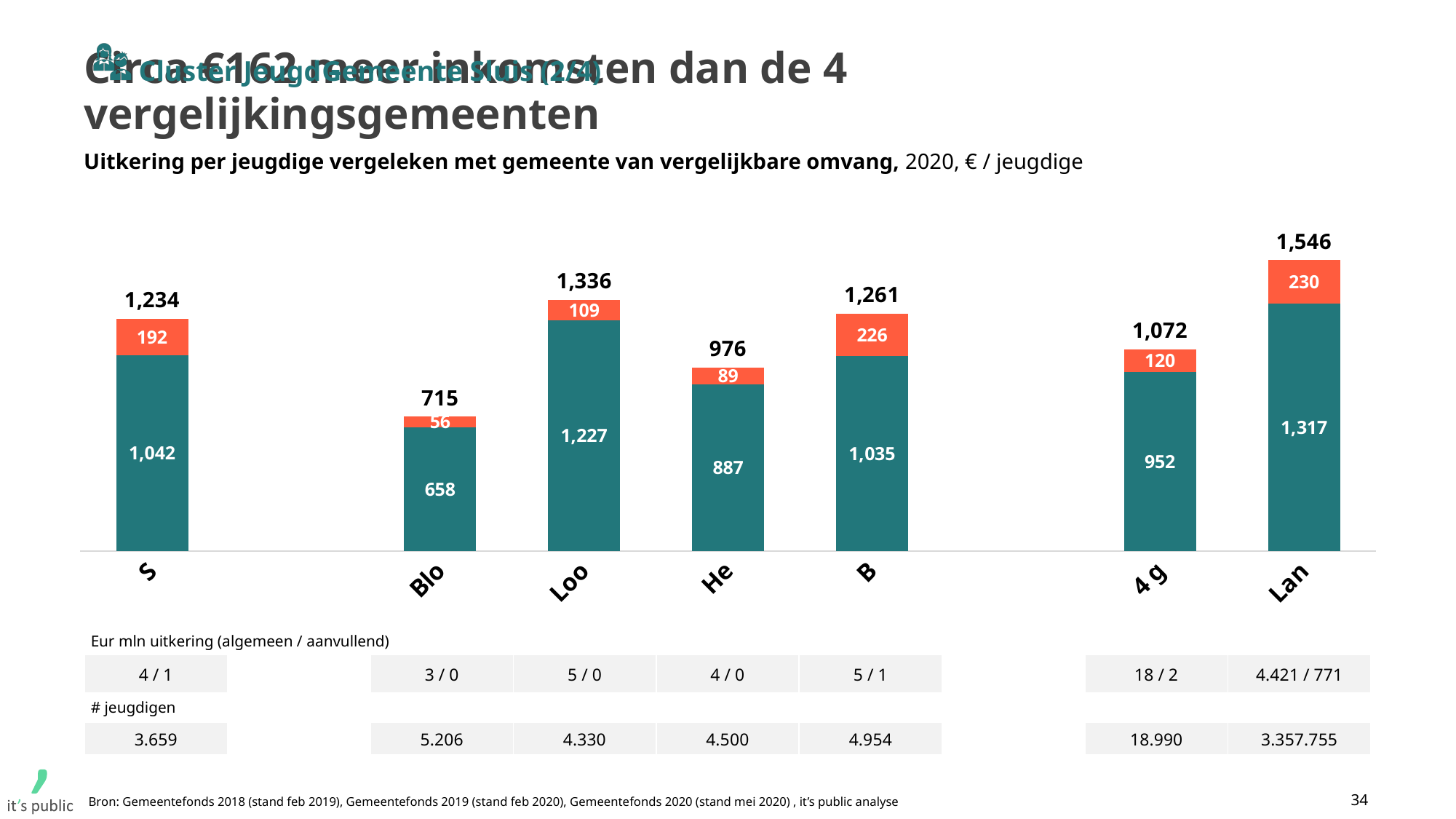
What is the value of the orange (upper) segment for B? 226 What is the total value shown above the bar for Lan? 1,546 Which category has the lowest total value? Blo Which category has the highest total value? Lan What kind of chart is shown on the slide? Stacked bar chart What is the value of the teal (lower) segment for Loo? 1,227 How many categories are shown on the x axis of the chart? 7 What is the difference between the total for S and the total for He? 258 What is the total value shown above the bar for 4 g? 1,072 What is the value of the orange (upper) segment for Blo? 56 Which has a larger total value, Loo or B? Loo What is the difference between the total for Lan and the total for Blo? 831